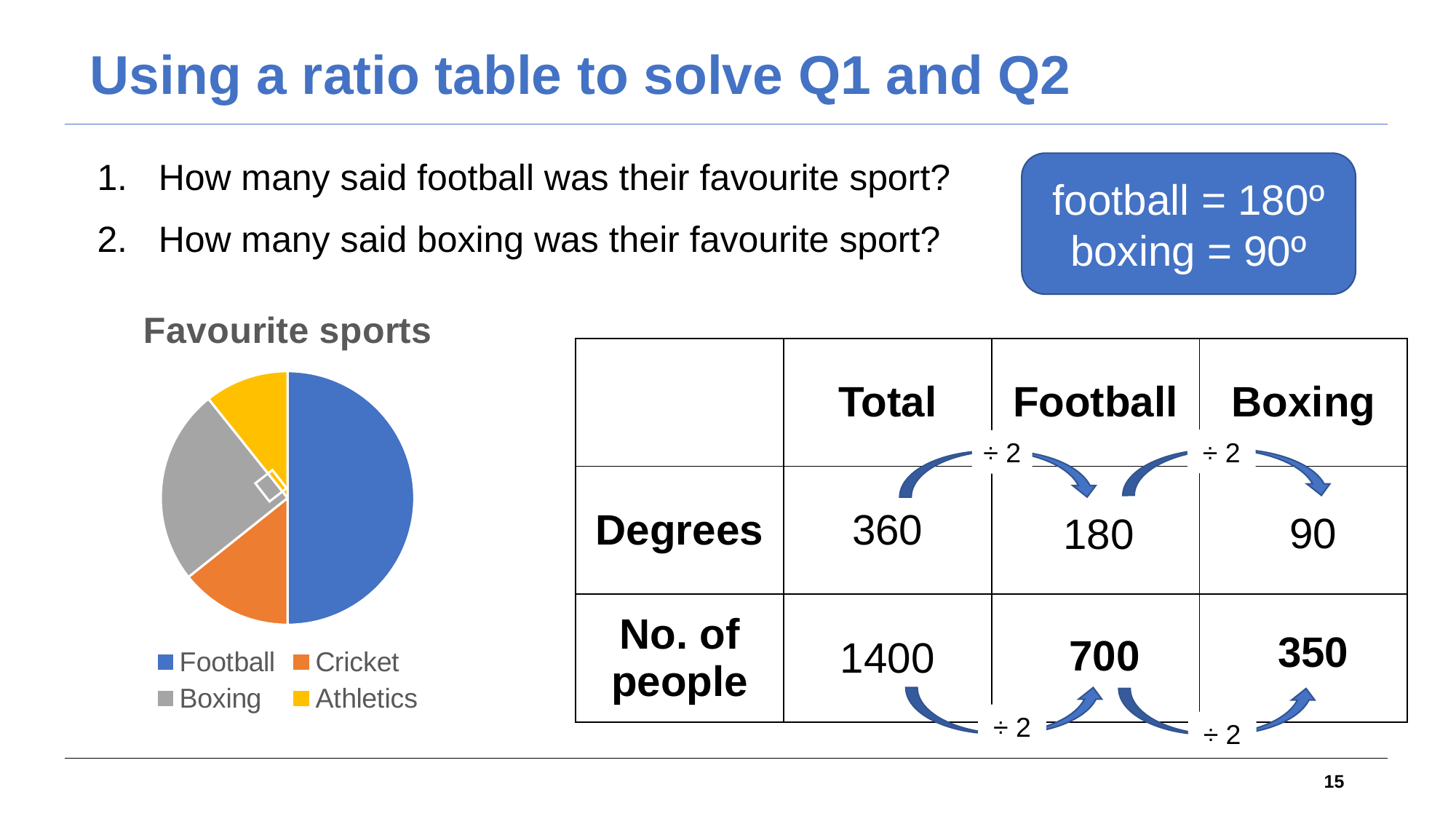
According to the slide, how many degrees does the boxing slice represent? 90º According to the ratio table, how many people said football was their favourite sport? 700 What is the title of the chart? Favourite sports Which slice is larger, Boxing or Cricket? Boxing What kind of chart is shown on the slide? pie chart How many categories does the pie chart show? 4 Which slice is larger, Football or Boxing? Football What colour is the Football slice in the pie chart? blue Which sport has the largest slice of the pie chart? Football According to the slide, how many degrees does the football slice represent? 180º How many entries does the chart legend list? 4 According to the ratio table, how many people said boxing was their favourite sport? 350